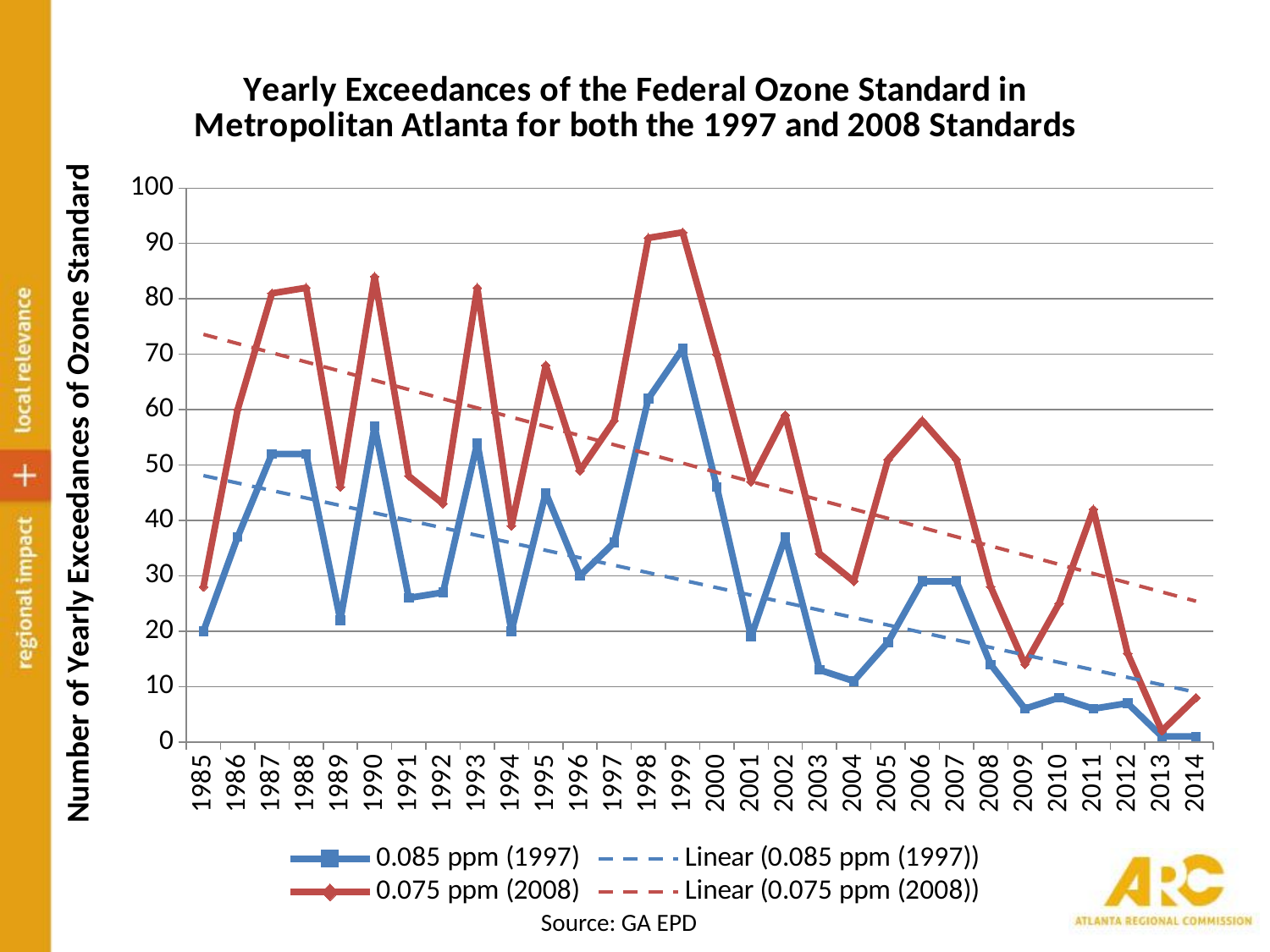
How many years are plotted along the x axis? 30 What kind of chart is shown on the slide? Line chart How many entries does the legend list? 4 Is the value for the 0.075 ppm (2008) series in 1995 greater or less than 60? greater Is the value for the 0.075 ppm (2008) series in 1990 greater or less than 80? greater Is the value for the 0.085 ppm (1997) series in 2009 greater or less than 10? less What source is cited below the chart? GA EPD Do the exceedance values generally rise or fall from 1985 to 2014? Fall In which year does the 0.075 ppm (2008) series reach its lowest value? 2013 For the 0.075 ppm (2008) series, which year has the larger value, 1998 or 2006? 1998 In which year does the 0.085 ppm (1997) series reach its highest value? 1999